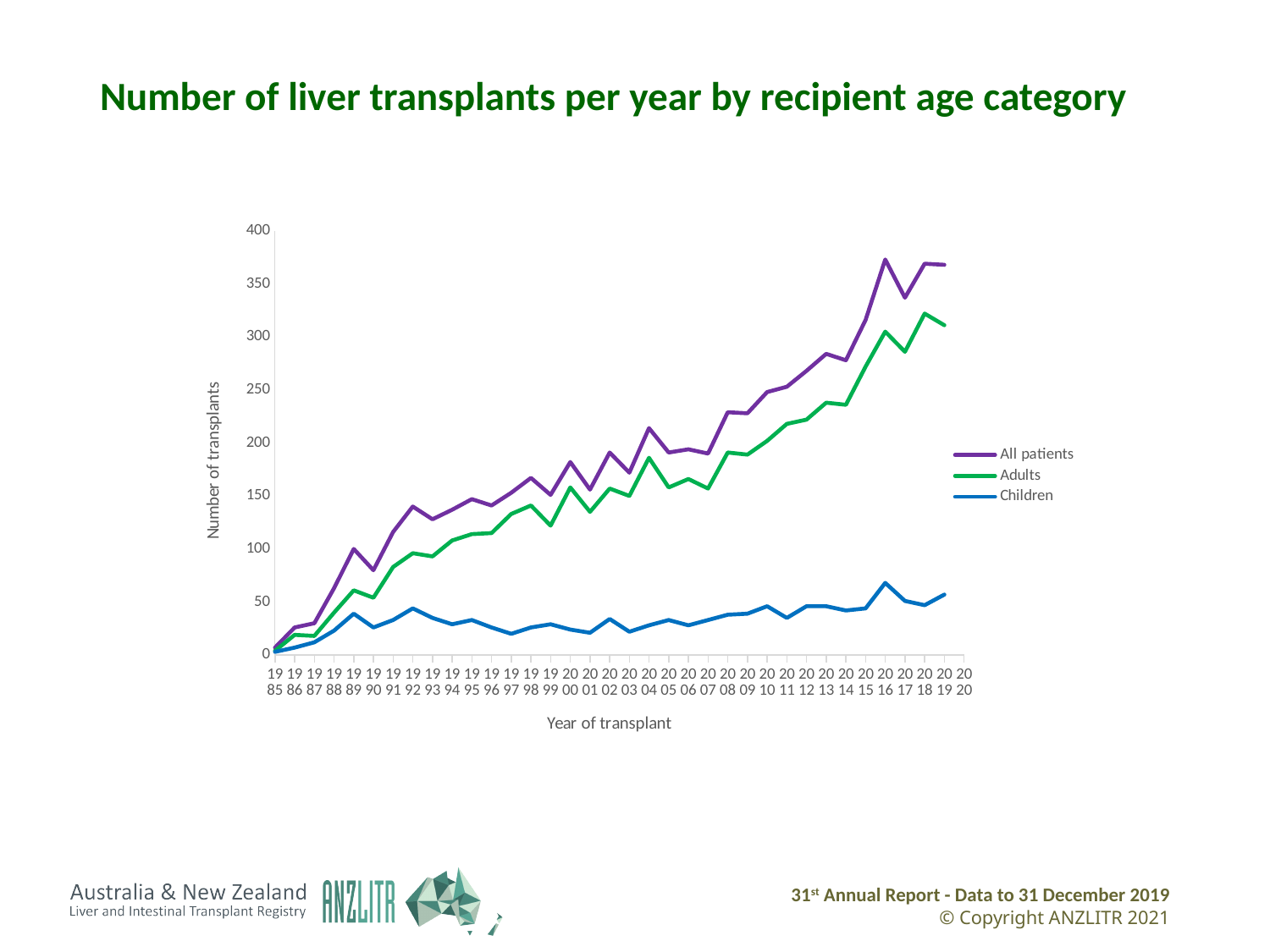
In which year does the All patients line reach its highest point? 2016 Is the value for Adults in 1990 greater or less than 100? less Which series has the highest values throughout the chart? All patients Which series has the larger value in 2019, Adults or Children? Adults What kind of chart is shown on the slide? Line chart In which year is the All patients value lowest? 1985 What is the title of the vertical axis? Number of transplants Is the value for Children in 2016 greater or less than 50? greater Is the value for Adults in 2019 greater or less than 300? greater How many series does the legend list? 3 Does the All patients line generally rise or fall from 1985 to 2019? Rise